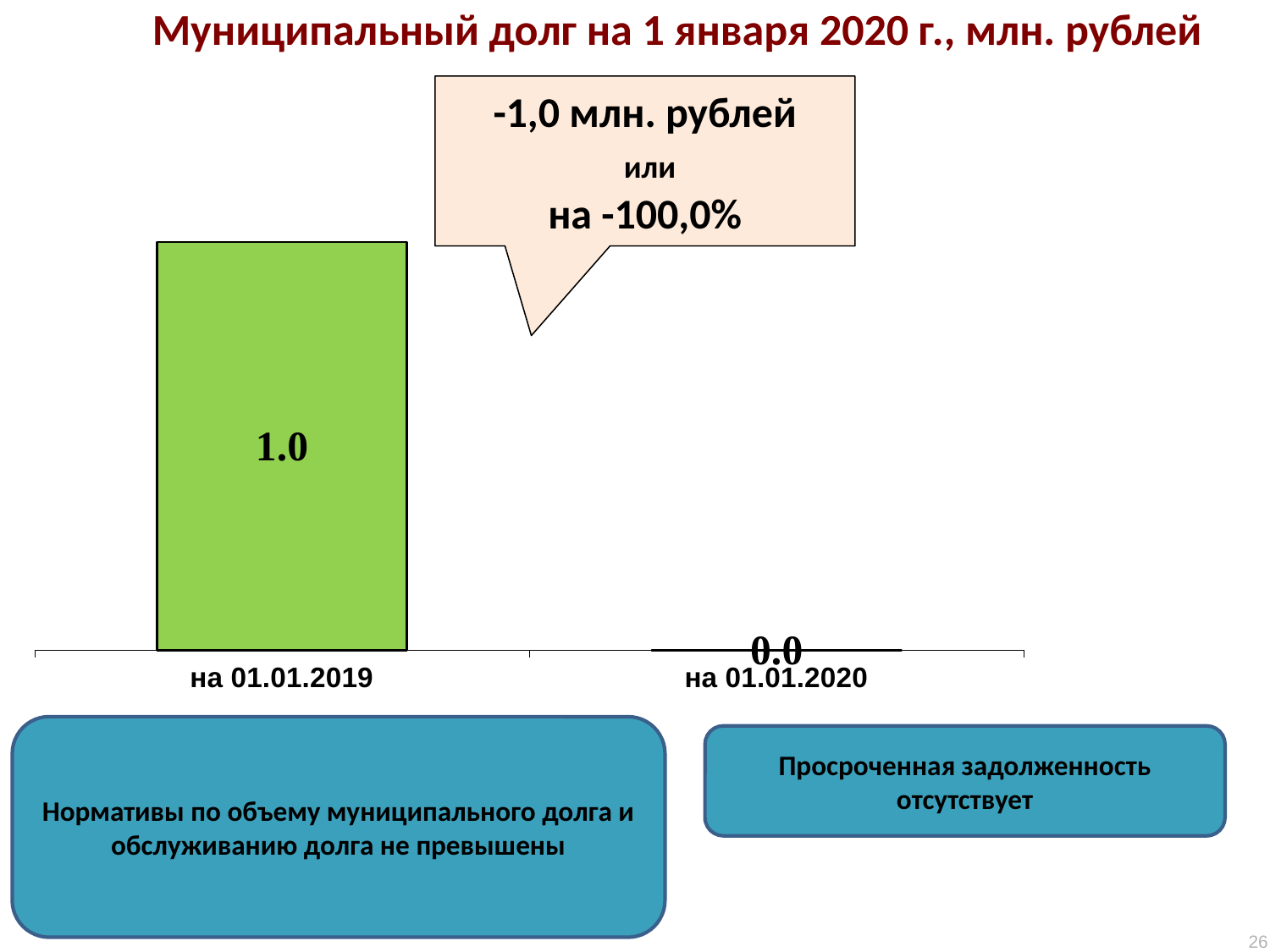
Do the values rise or fall from на 01.01.2019 to на 01.01.2020? fall What is the value for на 01.01.2020? 0.0 What is the value for на 01.01.2019? 1.0 What kind of chart is shown on the slide? bar chart Which is larger, the value for на 01.01.2019 or the value for на 01.01.2020? на 01.01.2019 How many categories are shown on the x axis? 2 Which category has the lowest value? на 01.01.2020 What is the difference between the values for на 01.01.2019 and на 01.01.2020? 1.0 Which category has the highest value? на 01.01.2019 What is the title of the chart? Муниципальный долг на 1 января 2020 г., млн. рублей What change does the callout above the chart state in million rubles? -1,0 млн. рублей